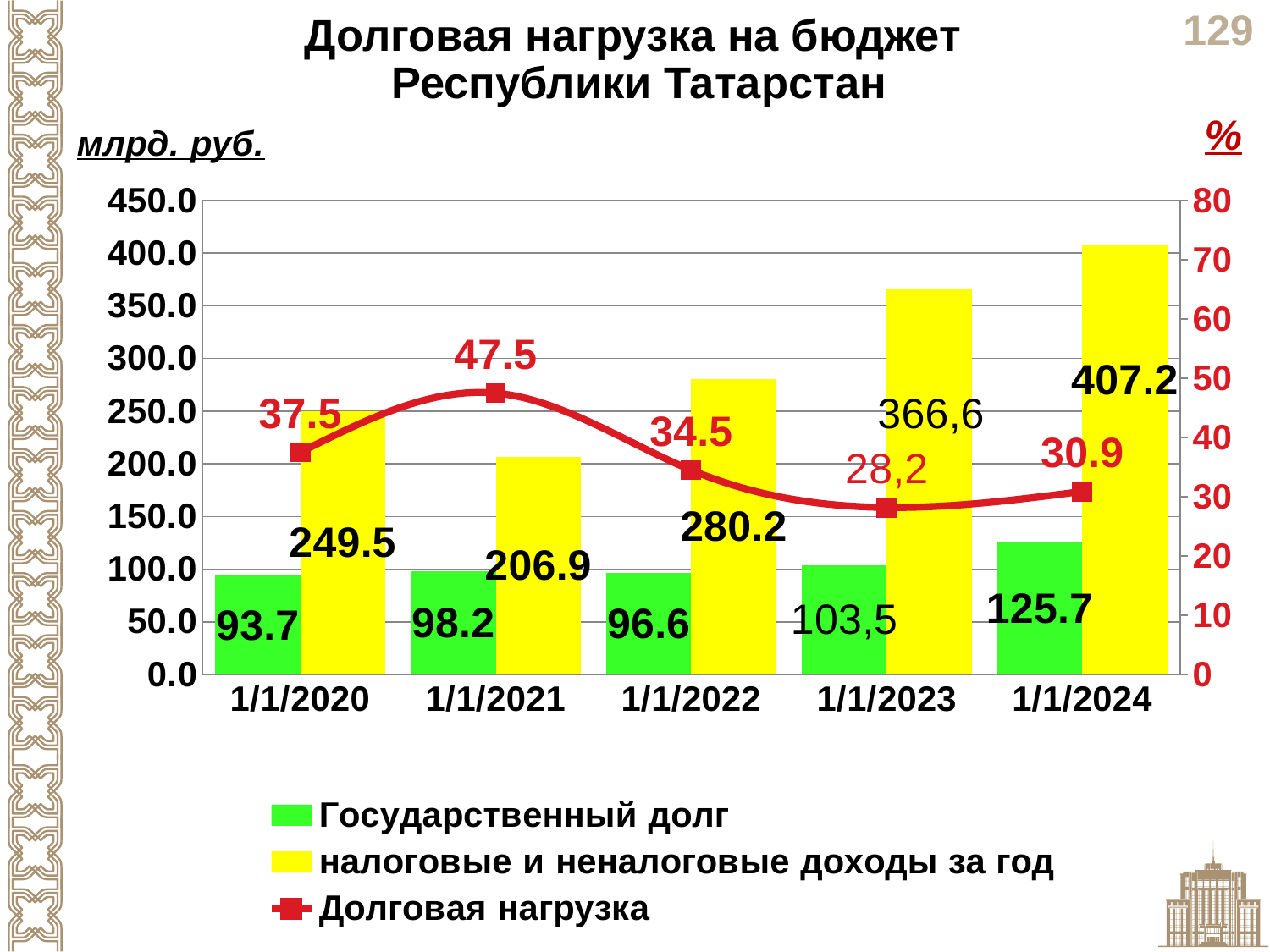
Does налоговые и неналоговые доходы за год rise or fall from 1/1/2022 to 1/1/2024? rise How many dates are shown on the x axis? 5 On which date is налоговые и неналоговые доходы за год the lowest? 1/1/2021 Which is larger: Государственный долг on 1/1/2021 or on 1/1/2022? 1/1/2021 What is the value of налоговые и неналоговые доходы за год on 1/1/2022? 280.2 How many series does the legend list? 3 On which date is Долговая нагрузка the highest? 1/1/2021 What is the value of Государственный долг on 1/1/2023? 103,5 What is the value of Государственный долг on 1/1/2024? 125.7 What is the difference between налоговые и неналоговые доходы за год on 1/1/2024 and on 1/1/2020? 157.7 What is the Долговая нагрузка value on 1/1/2021? 47.5 On which date is Долговая нагрузка the lowest? 1/1/2023